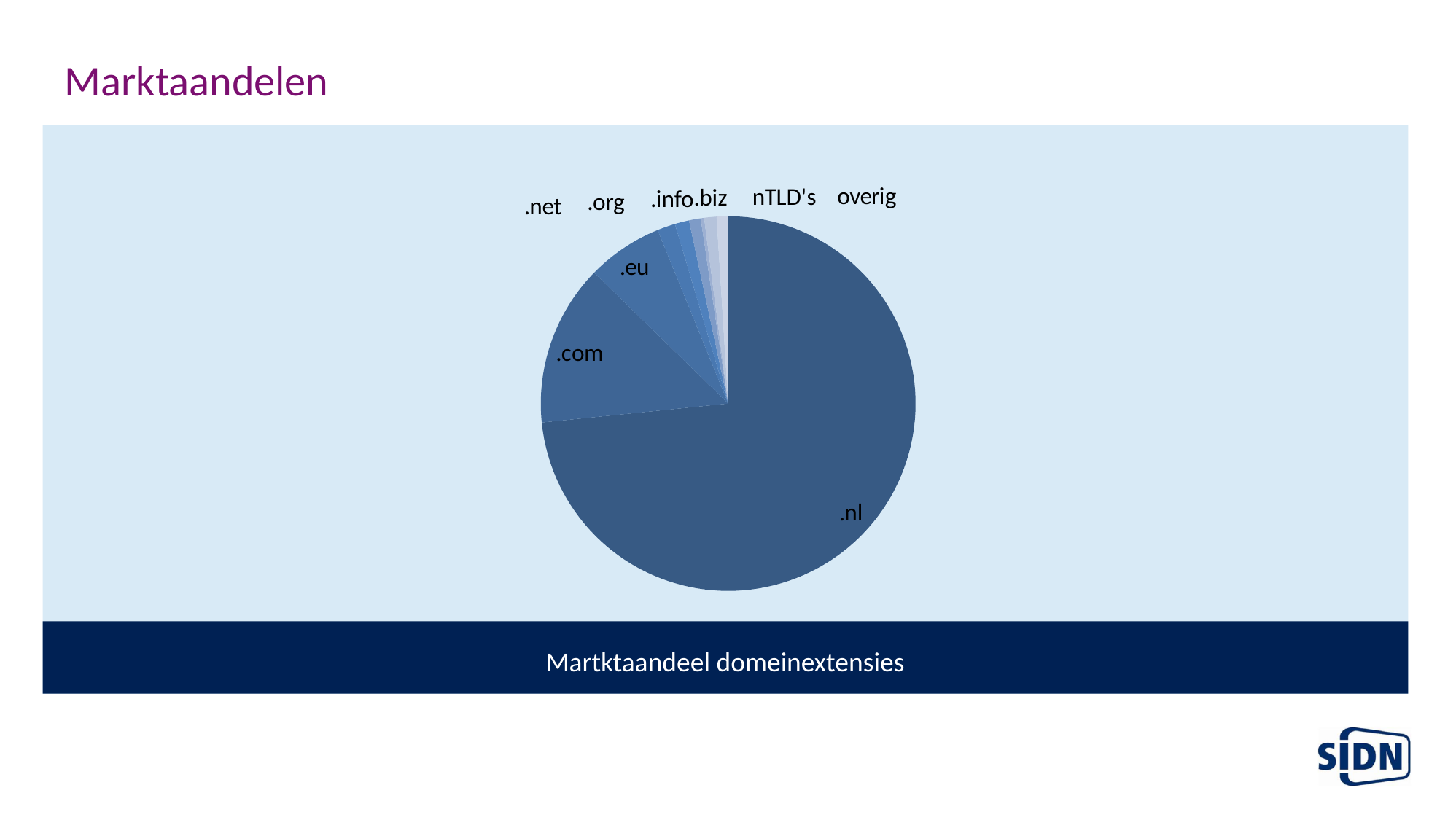
Which slice is larger, .eu or .net? .eu Which slice is larger, .nl or .com? .nl What is the caption shown below the pie chart? Martktaandeel domeinextensies Which domain extension has the largest slice of the pie? .nl Which slice is larger, .com or .eu? .com What kind of chart is shown on the slide? pie chart What is the title of the slide? Marktaandelen Which domain extension has the second-largest slice of the pie? .com How many slices does the pie chart have? 9